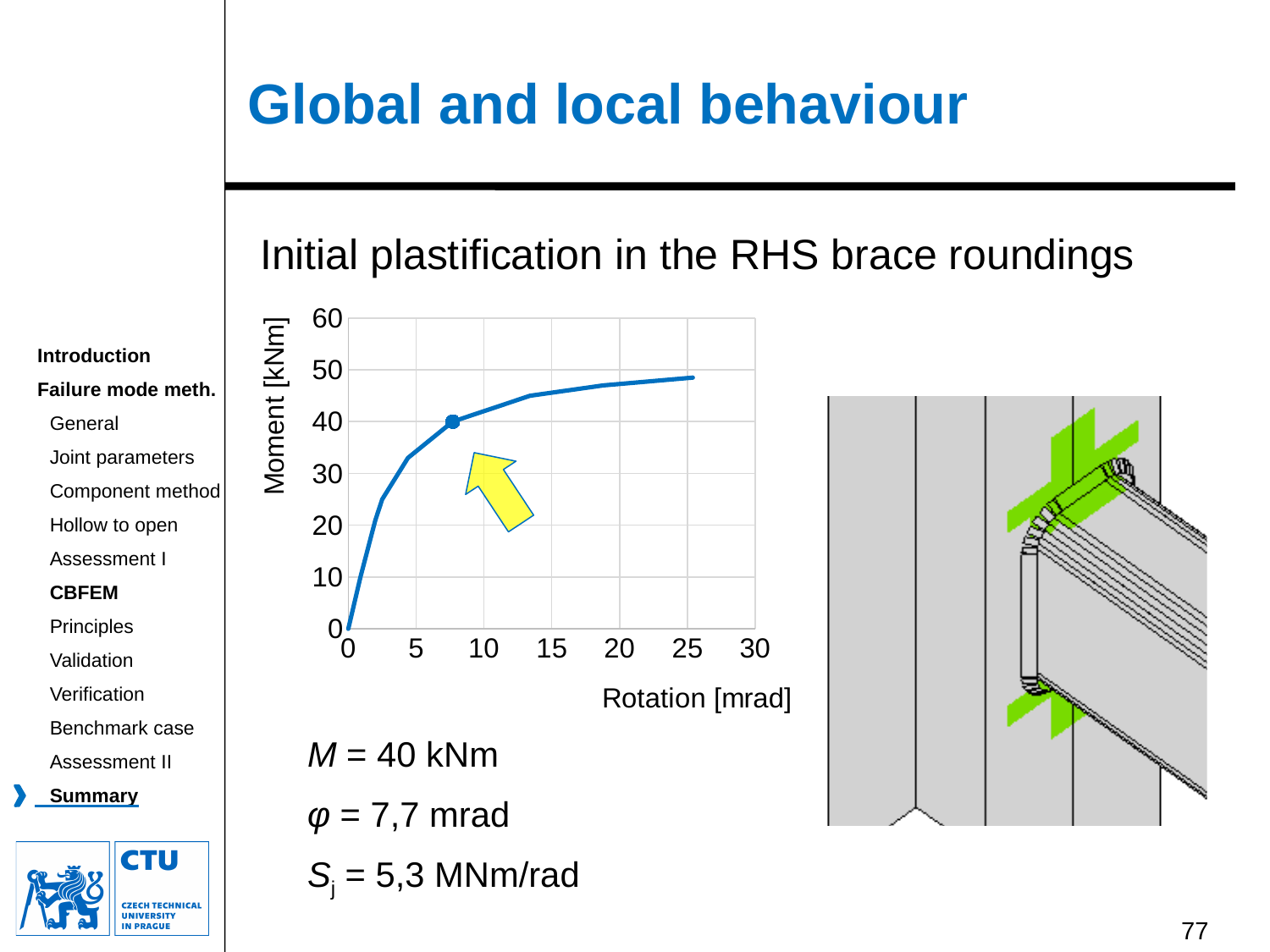
What rotation value corresponds to the highlighted point on the curve? 7,7 mrad What is the highest value shown on the vertical axis of the chart? 60 What moment value corresponds to the highlighted point on the curve? 40 kNm Is the moment at a rotation of 2 mrad greater or less than 10 kNm? greater Does the moment rise or fall as the rotation increases along the x axis? rise Is the moment at a rotation of 5 mrad greater or less than 40 kNm? less What is the label of the vertical axis of the chart? Moment [kNm] Is the moment at a rotation of 15 mrad greater or less than 50 kNm? less Is the moment at the highlighted point greater or less than the moment at the end of the curve near 25 mrad? less What kind of chart is shown on the slide? line chart What is the label of the horizontal axis of the chart? Rotation [mrad]